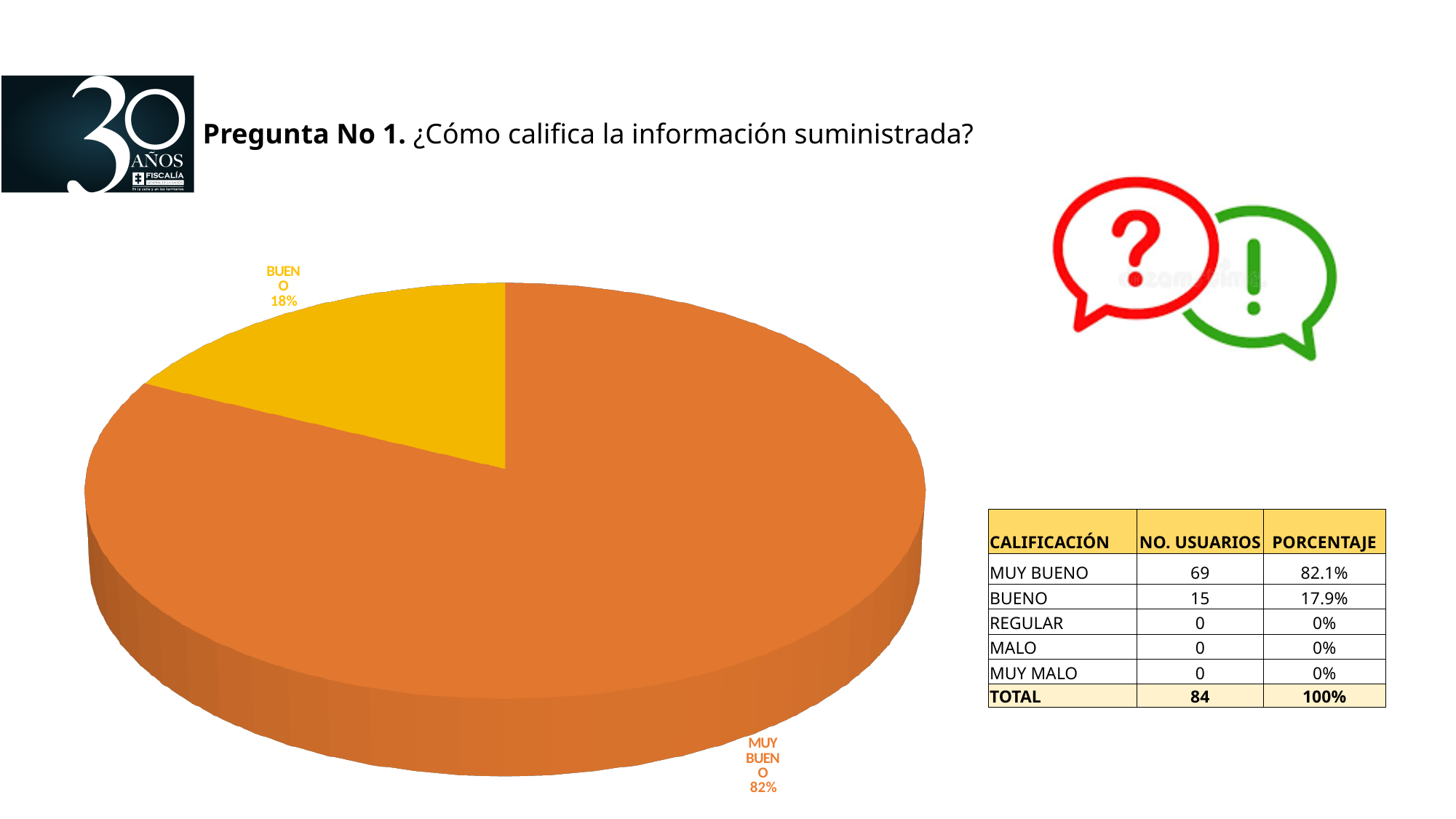
How many slices are labelled on the pie chart? 2 What kind of chart is shown on the slide? pie chart Which is larger on the pie chart, MUY BUENO or BUENO? MUY BUENO Which slice of the pie chart is the smallest? BUENO Is the share of the MUY BUENO slice greater or less than 50%? greater What colour is the MUY BUENO slice of the pie chart? orange What percentage does the BUENO slice show on the pie chart? 18% What is the difference in percentage points between the MUY BUENO and BUENO slices on the pie chart? 64 Is the share of the BUENO slice greater or less than 25%? less What percentage does the MUY BUENO slice show on the pie chart? 82% What colour is the BUENO slice of the pie chart? yellow Which slice of the pie chart is the largest? MUY BUENO